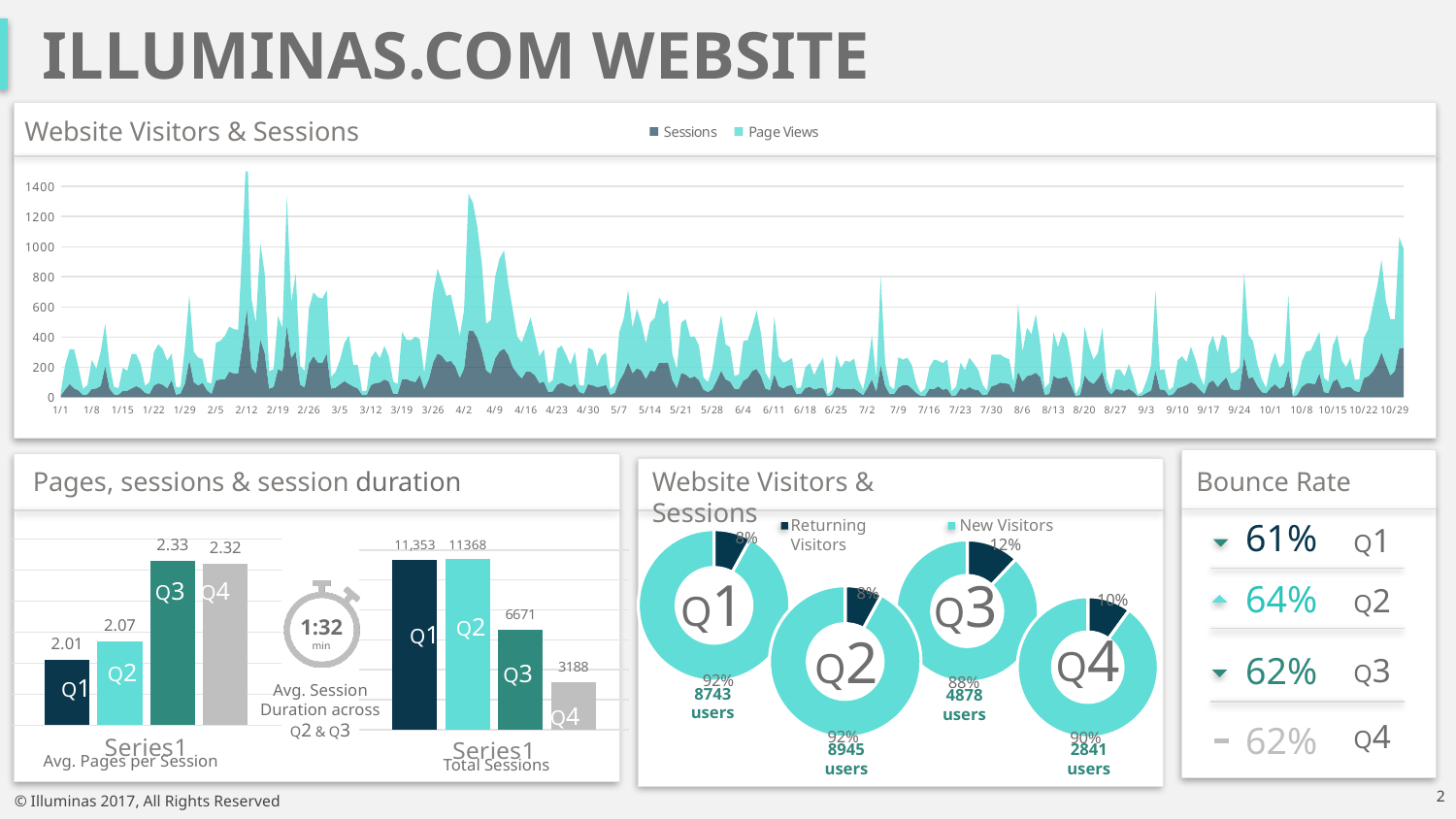
In the 'Website Visitors & Sessions' donut charts, how many users are shown for Q2? 8945 users In the 'Pages, sessions & session duration' chart, what is the Avg. Session Duration across Q2 & Q3 shown on the stopwatch? 1:32 min In the 'Pages, sessions & session duration' chart, what is the difference in Total Sessions between Q3 and Q4? 3483 How many series does the legend of the top 'Website Visitors & Sessions' chart list? 2 In the 'Pages, sessions & session duration' chart, which quarter has the lowest Avg. Pages per Session? Q1 In the 'Bounce Rate' panel, which quarter has the highest bounce rate? Q2 In the 'Pages, sessions & session duration' chart, which quarter has the lowest Total Sessions? Q4 In the 'Pages, sessions & session duration' chart, what is the Total Sessions value for Q3? 6671 In the 'Website Visitors & Sessions' donut charts, what is the difference in users between Q2 and Q1? 202 In the 'Pages, sessions & session duration' chart, what is the Avg. Pages per Session value for Q1? 2.01 In the 'Website Visitors & Sessions' donut charts, which quarter has the fewest users? Q4 In the 'Website Visitors & Sessions' donut charts, what percentage of Q3 visitors are New Visitors? 88%